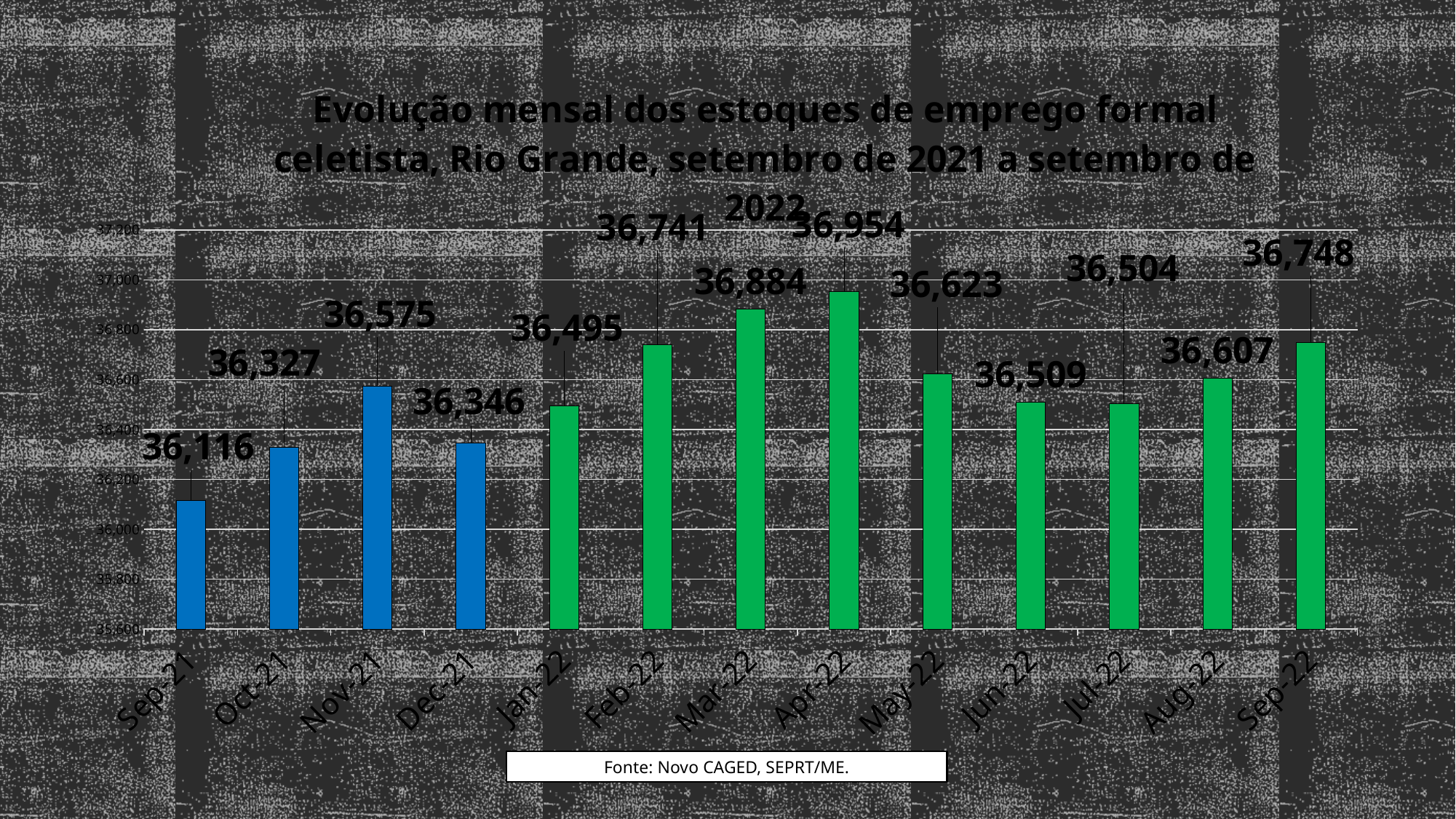
Which month has the lowest value? Sep-21 What is the value for Dec-21? 36,346 Which month has the highest value? Apr-22 Which is larger, the value for Nov-21 or the value for Dec-21? Nov-21 Is the value for Mar-22 greater or less than 36,800? greater What is the value for Apr-22? 36,954 What is the value for Sep-21? 36,116 What is the difference between the values for Apr-22 and Mar-22? 70 How many months are shown on the x axis? 13 What colour are the bars for the 2021 months? Blue What kind of chart is shown on the slide? Bar chart What is the difference between the values for Sep-22 and Sep-21? 632